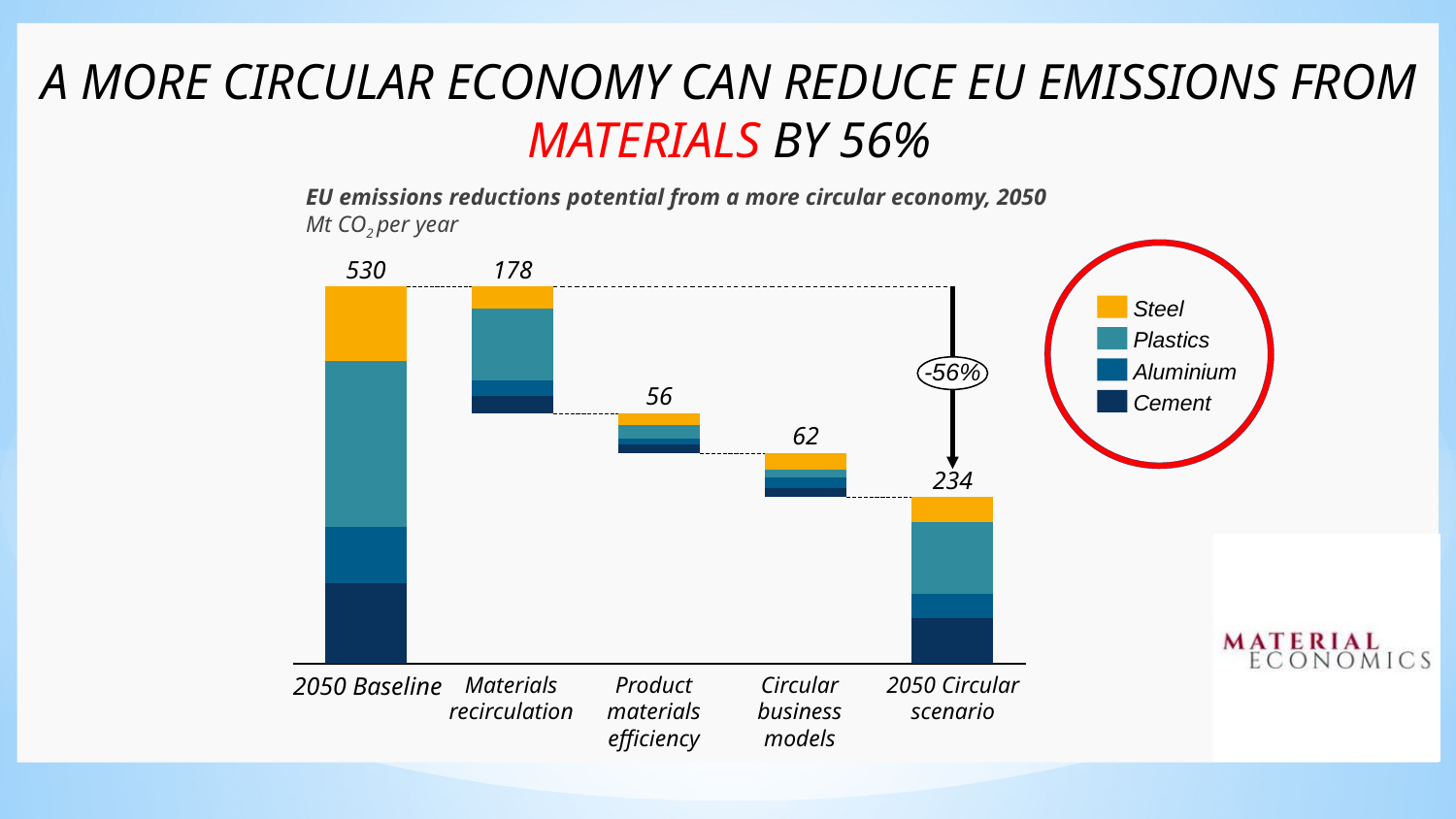
What is the value for the 2050 Circular scenario bar? 234 What is the difference between the 2050 Baseline and the 2050 Circular scenario values? 296 Which category has the lowest value? Product materials efficiency What is the value for Product materials efficiency? 56 How many categories are shown on the x axis? 5 What is the value for the 2050 Baseline bar? 530 What percentage reduction is shown by the arrow annotation on the chart? -56% Which category has the highest value? 2050 Baseline How many series does the legend list? 4 Which is larger, the value for Circular business models or the value for Product materials efficiency? Circular business models What is the value for Materials recirculation? 178 What unit is given in the chart subtitle? Mt CO2 per year